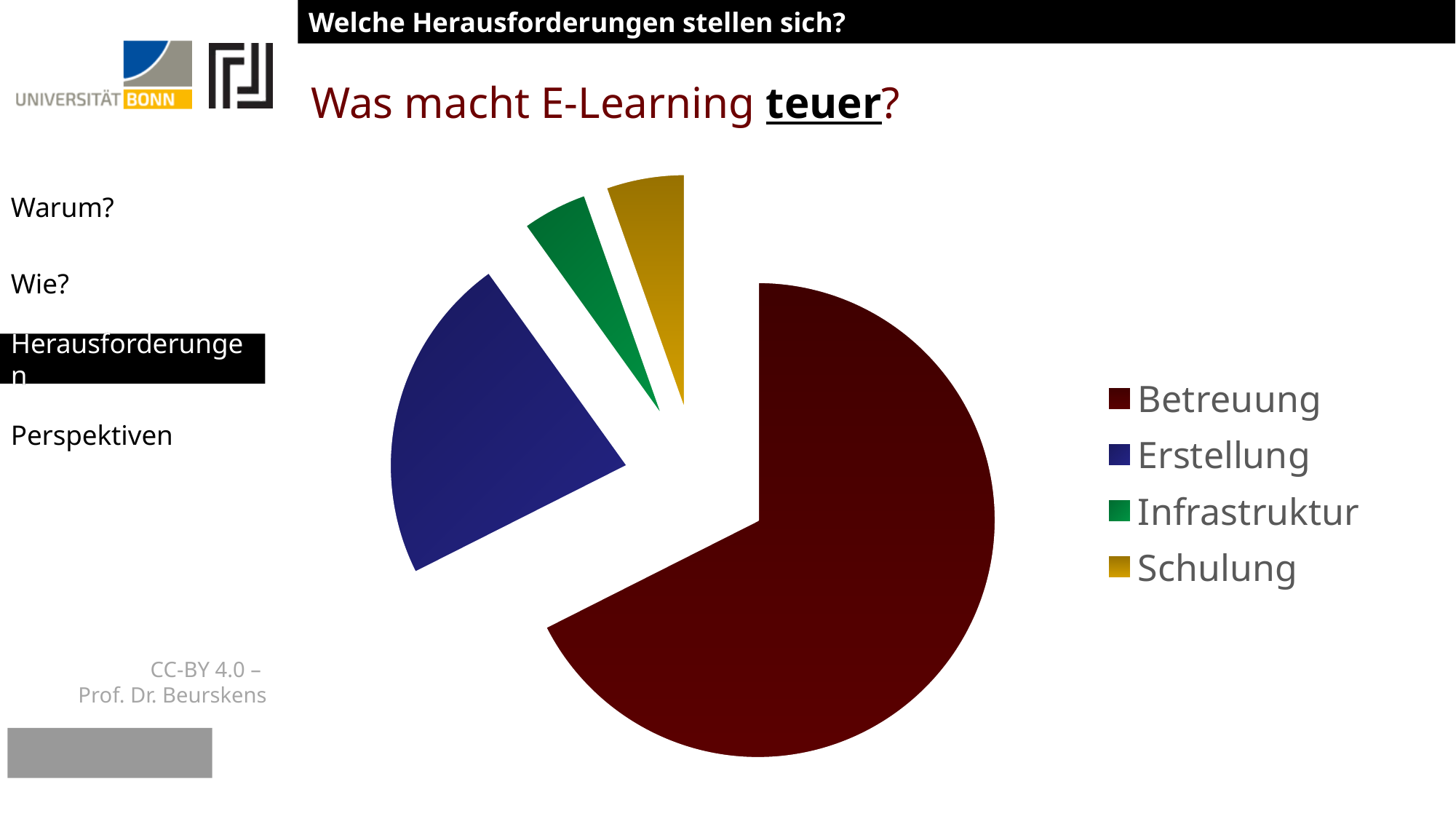
Which slice is larger, Betreuung or Erstellung? Betreuung How many entries does the legend of the pie chart list? 4 How many slices does the pie chart have? 4 What is the title of the chart on the slide? Was macht E-Learning teuer? Which slice is larger, Erstellung or Schulung? Erstellung Does the Betreuung slice take up more or less than half of the pie? more Which colour represents Infrastruktur in the pie chart? green Which slice is larger, Erstellung or Infrastruktur? Erstellung What kind of chart is shown on the slide? pie chart Which category has the largest slice of the pie chart? Betreuung